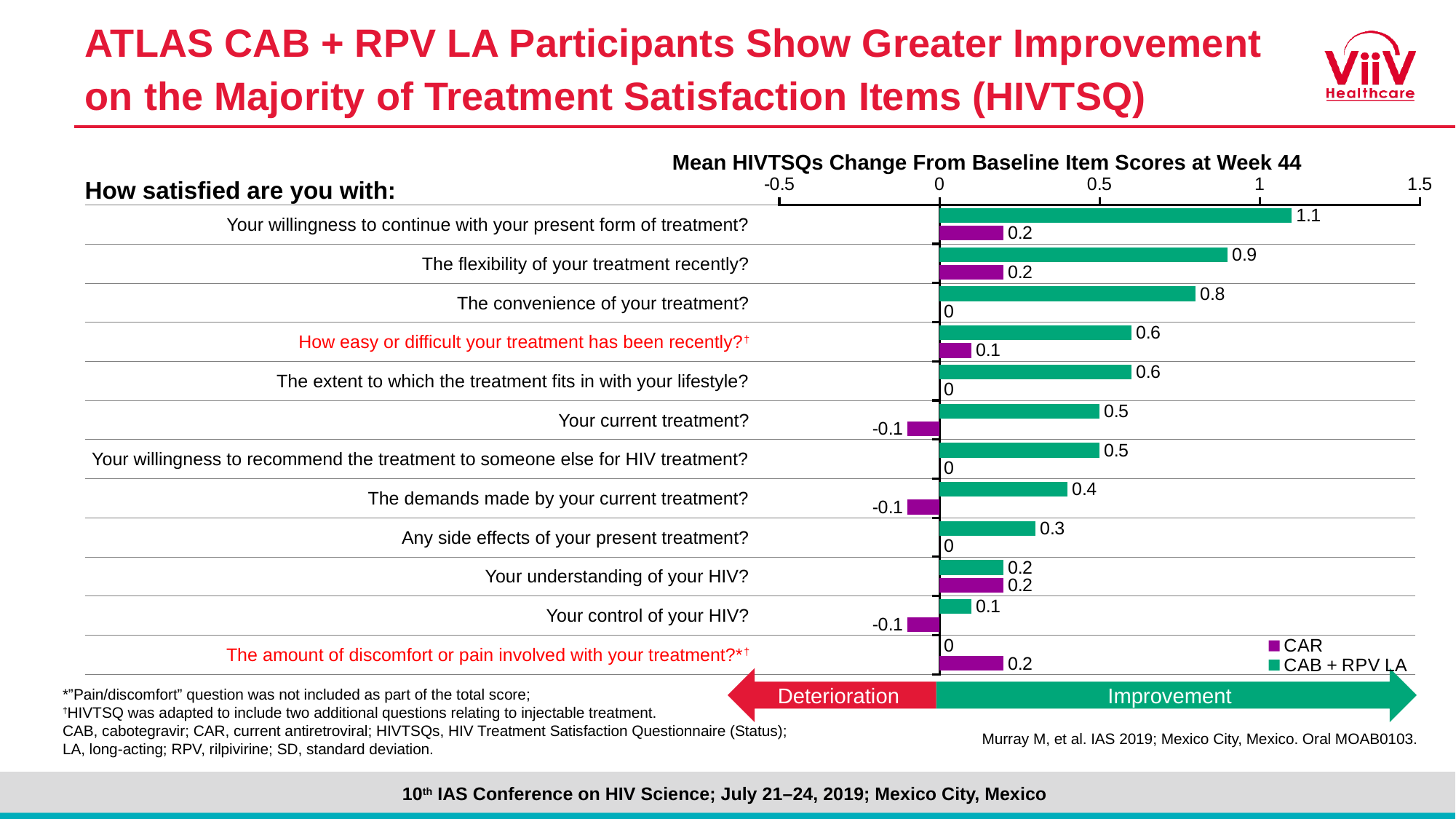
What is the CAB + RPV LA value for "Your willingness to continue with your present form of treatment?" 1.1 What is the CAR value for "The flexibility of your treatment recently?" 0.2 What is the CAB + RPV LA value for "The amount of discomfort or pain involved with your treatment?" 0 What is the CAR value for "Your current treatment?" -0.1 What type of chart is shown on the slide? Bar chart Which item has the lowest CAB + RPV LA value? The amount of discomfort or pain involved with your treatment? What is the difference between the CAB + RPV LA and CAR values for "The convenience of your treatment?" 0.8 What is the title of the chart? Mean HIVTSQs Change From Baseline Item Scores at Week 44 How many series does the legend list? 2 How many items (categories) are plotted in the chart? 12 Which item has the highest CAB + RPV LA value? Your willingness to continue with your present form of treatment? For "The amount of discomfort or pain involved with your treatment?", which series has the larger value, CAR or CAB + RPV LA? CAR